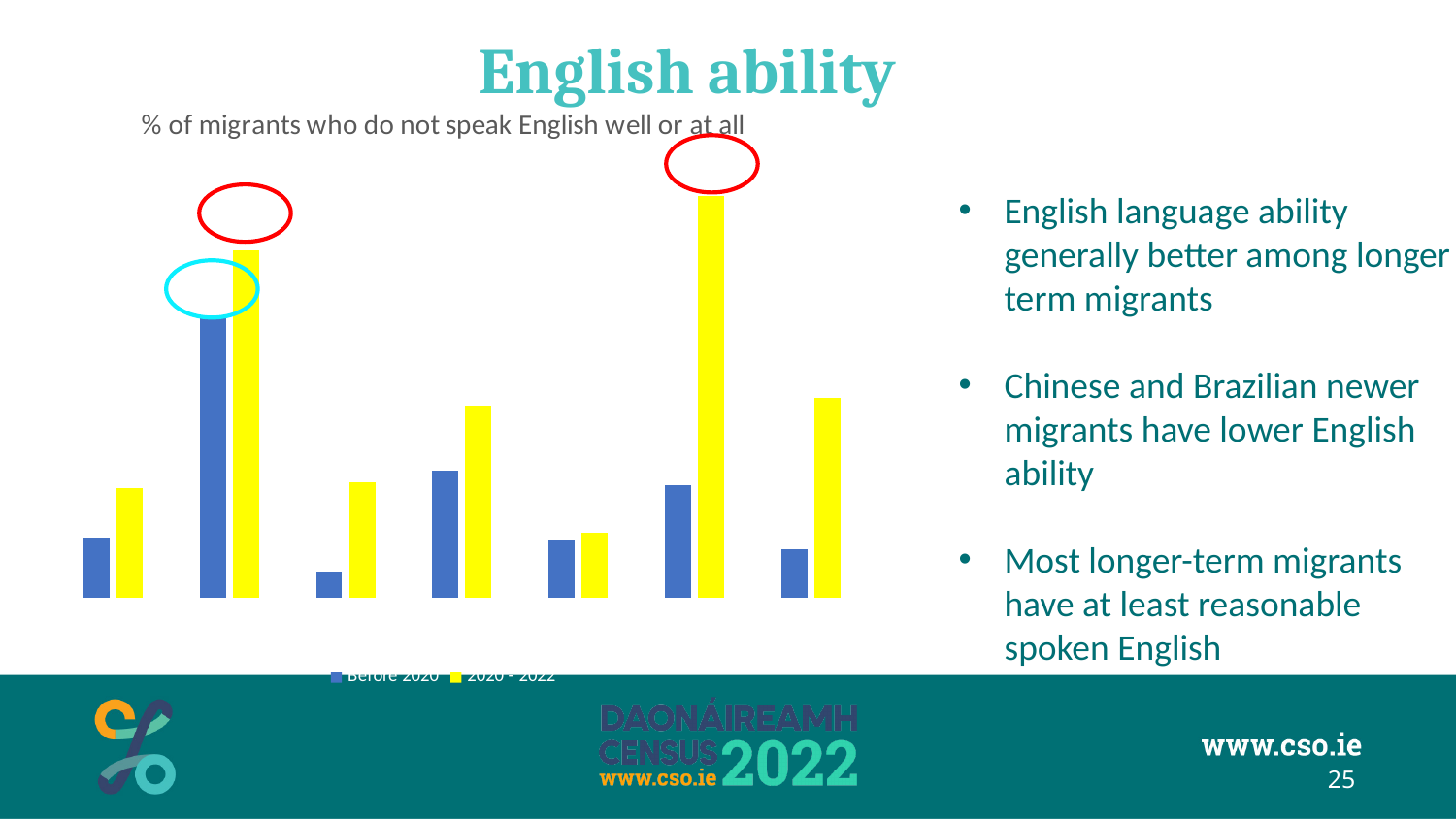
Which group of bars, counting from the left, has the tallest Before 2020 bar? The second In the second group of bars from the left, which series has the taller bar, Before 2020 or 2020 - 2022? 2020 - 2022 What is the subtitle describing what the chart measures? % of migrants who do not speak English well or at all Is the 2020 - 2022 bar taller than the Before 2020 bar in every group of the chart? Yes Which group of bars, counting from the left, has the tallest 2020 - 2022 bar? The sixth What kind of chart is shown on the slide? Bar chart In the sixth group of bars from the left, which series has the taller bar, Before 2020 or 2020 - 2022? 2020 - 2022 How many category groups of bars are plotted in the chart? 7 Which group of bars, counting from the left, has the shortest Before 2020 bar? The third How many series does the chart legend list? 2 What are the two series named in the chart legend? Before 2020 and 2020 - 2022 Which group of bars, counting from the left, has the shortest 2020 - 2022 bar? The fifth